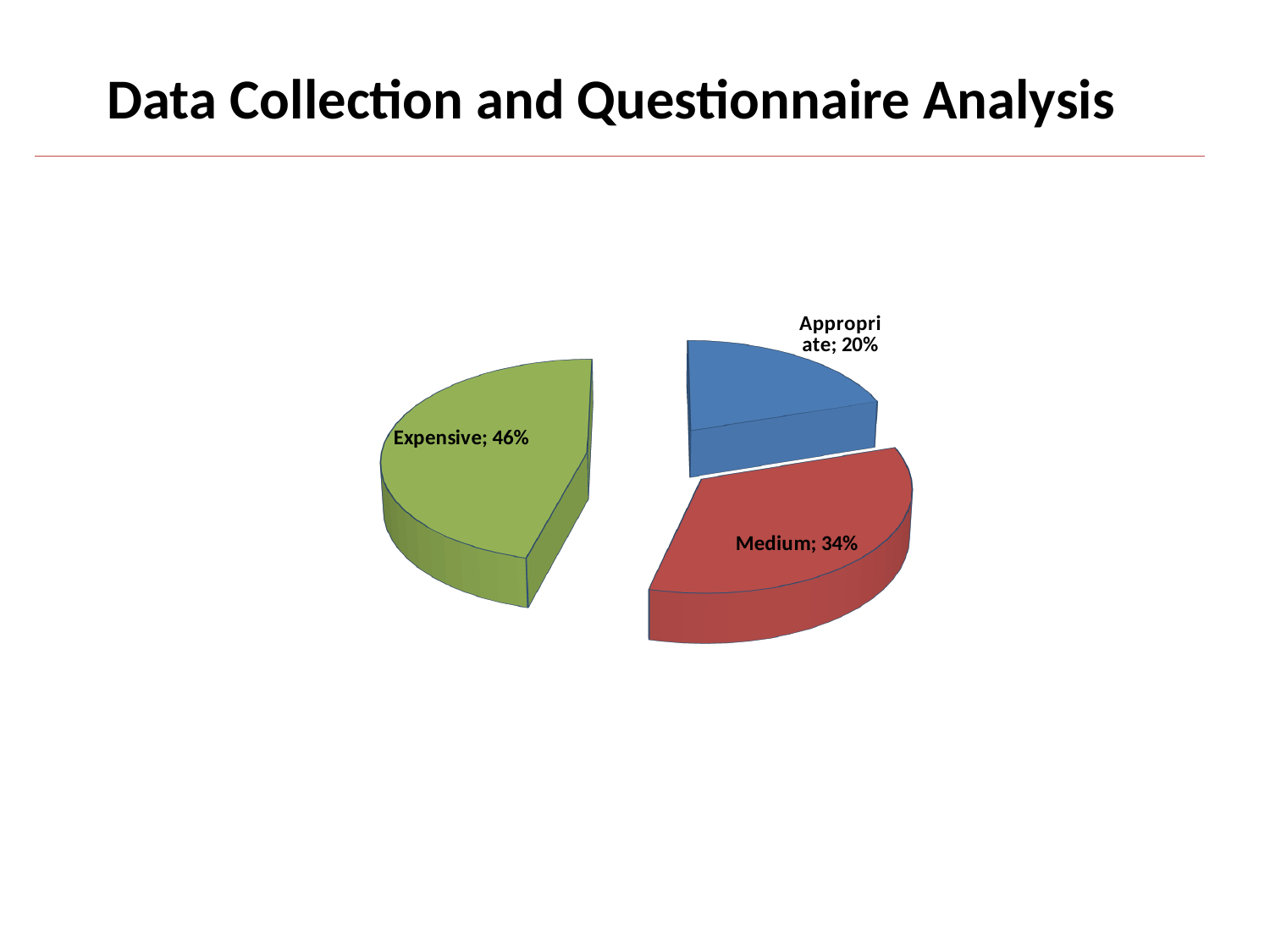
Which slice has the smallest share of the pie? Appropriate What is the difference in percentage points between the Expensive and Medium slices? 12 What kind of chart is shown on the slide? Pie chart Which is larger, the Medium slice or the Appropriate slice? Medium What percentage is shown for the Medium slice? 34% How many slices does the pie chart have? 3 What is the title of the slide containing the pie chart? Data Collection and Questionnaire Analysis What percentage is shown for the Appropriate slice? 20% What colour is the Expensive slice? Green Which slice has the largest share of the pie? Expensive What is the difference in percentage points between the Medium and Appropriate slices? 14 What percentage is shown for the Expensive slice? 46%